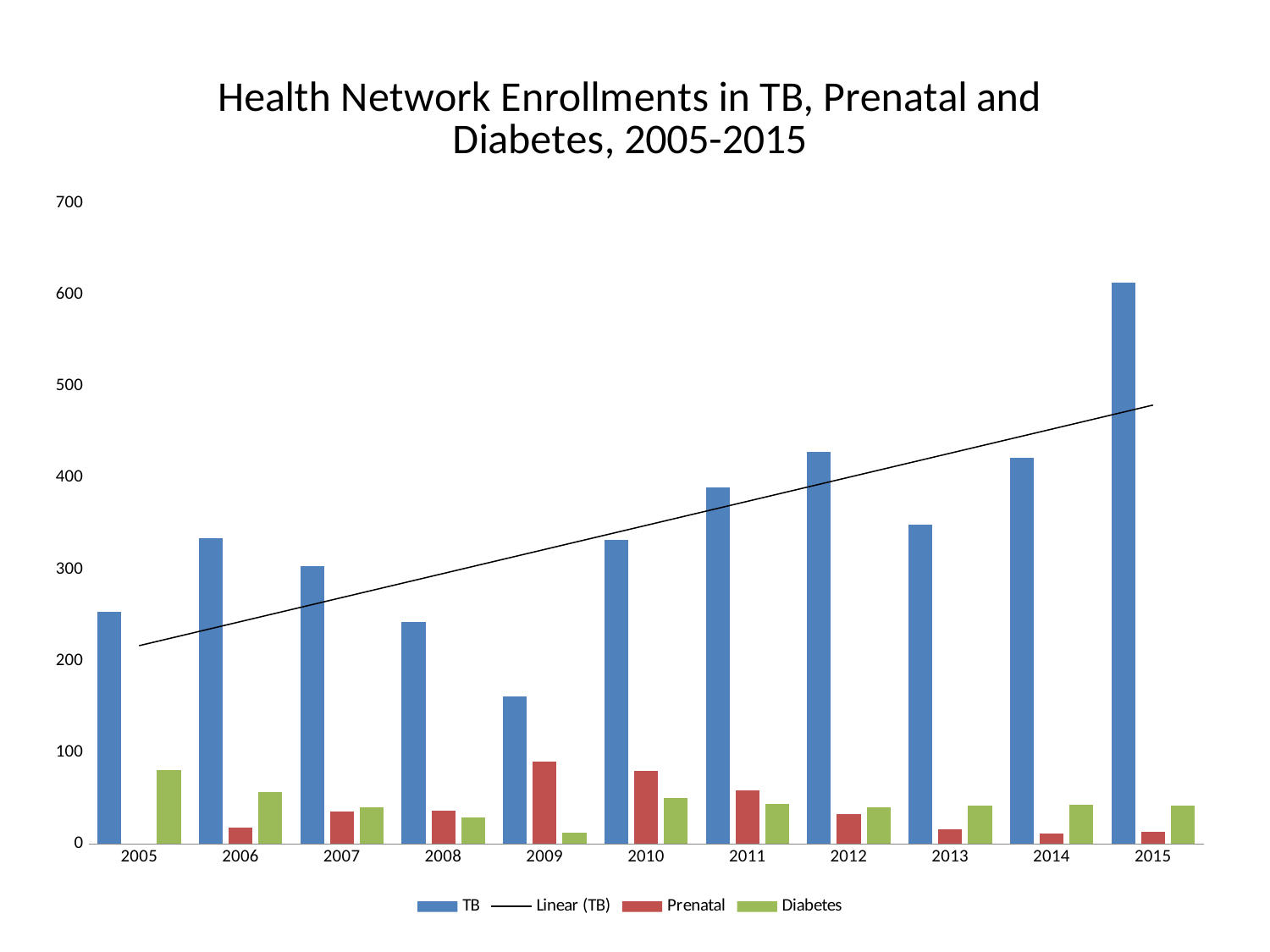
Is the TB value for 2009 greater or less than 200? less How many entries does the chart's legend list? 4 In which year is the Diabetes enrollment bar the highest? 2005 What is the title of the chart? Health Network Enrollments in TB, Prenatal and Diabetes, 2005-2015 In which year is the TB enrollment bar the highest? 2015 Is the Diabetes value for 2005 greater or less than 100? less Which is larger, the TB value for 2012 or the TB value for 2013? 2012 In which year is the Prenatal enrollment bar the highest? 2009 What kind of chart is shown on the slide? bar chart In which year is the TB enrollment bar the lowest? 2009 How many years are shown on the x axis of the chart? 11 Is the TB value for 2015 greater or less than 500? greater